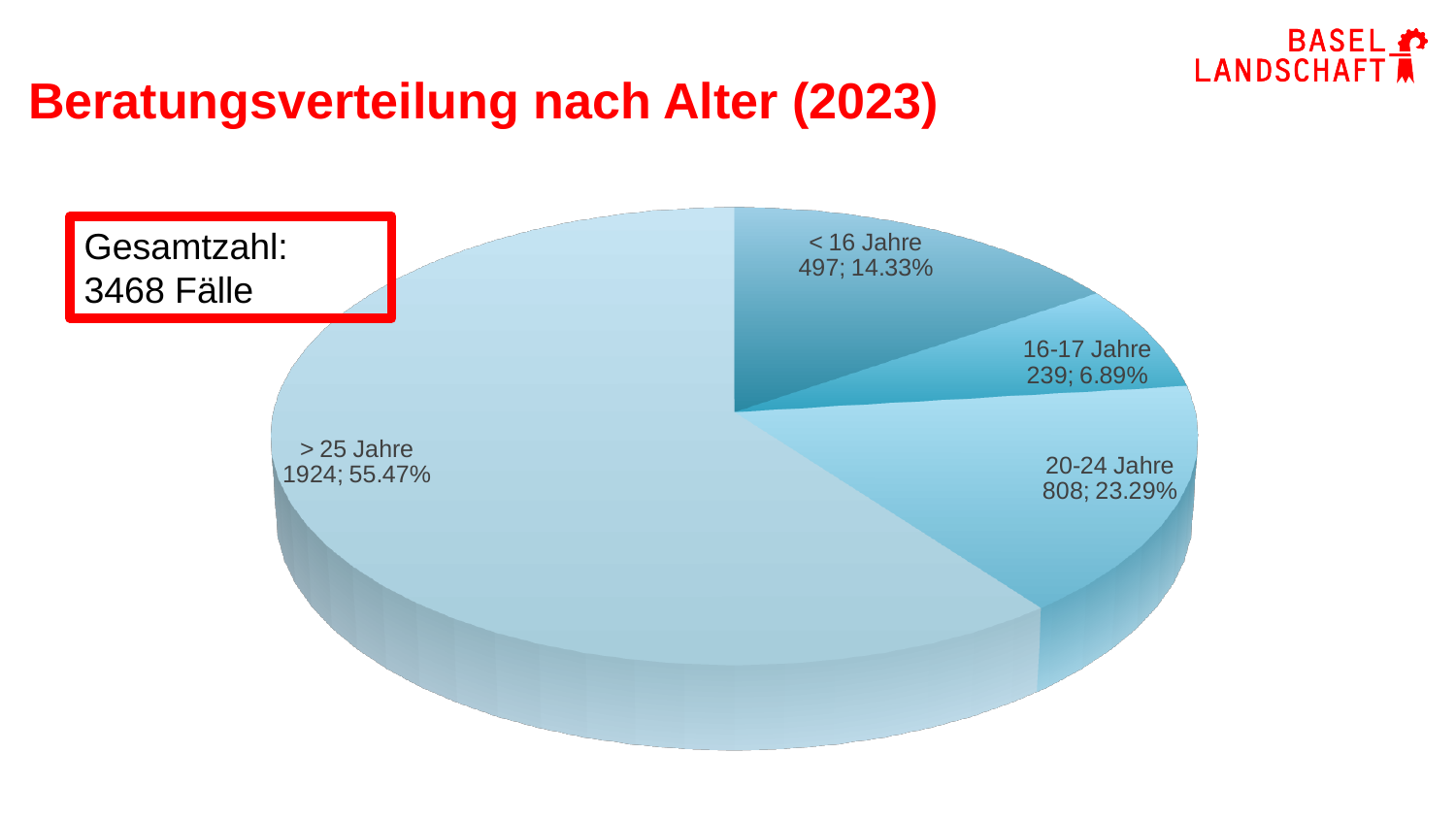
Which age group has the smallest slice? 16-17 Jahre What is the total number of cases stated on the slide? 3468 Fälle What percentage share does the '16-17 Jahre' slice have? 6.89% How many cases are in the '< 16 Jahre' slice? 497 Which age group has the largest slice? > 25 Jahre What is the difference in cases between '20-24 Jahre' and '< 16 Jahre'? 311 What is the title of the slide? Beratungsverteilung nach Alter (2023) What percentage share does the '20-24 Jahre' slice have? 23.29% What kind of chart is shown on the slide? pie chart How many cases are in the '> 25 Jahre' slice? 1924 Which has more cases, '< 16 Jahre' or '16-17 Jahre'? < 16 Jahre How many slices does the pie chart have? 4